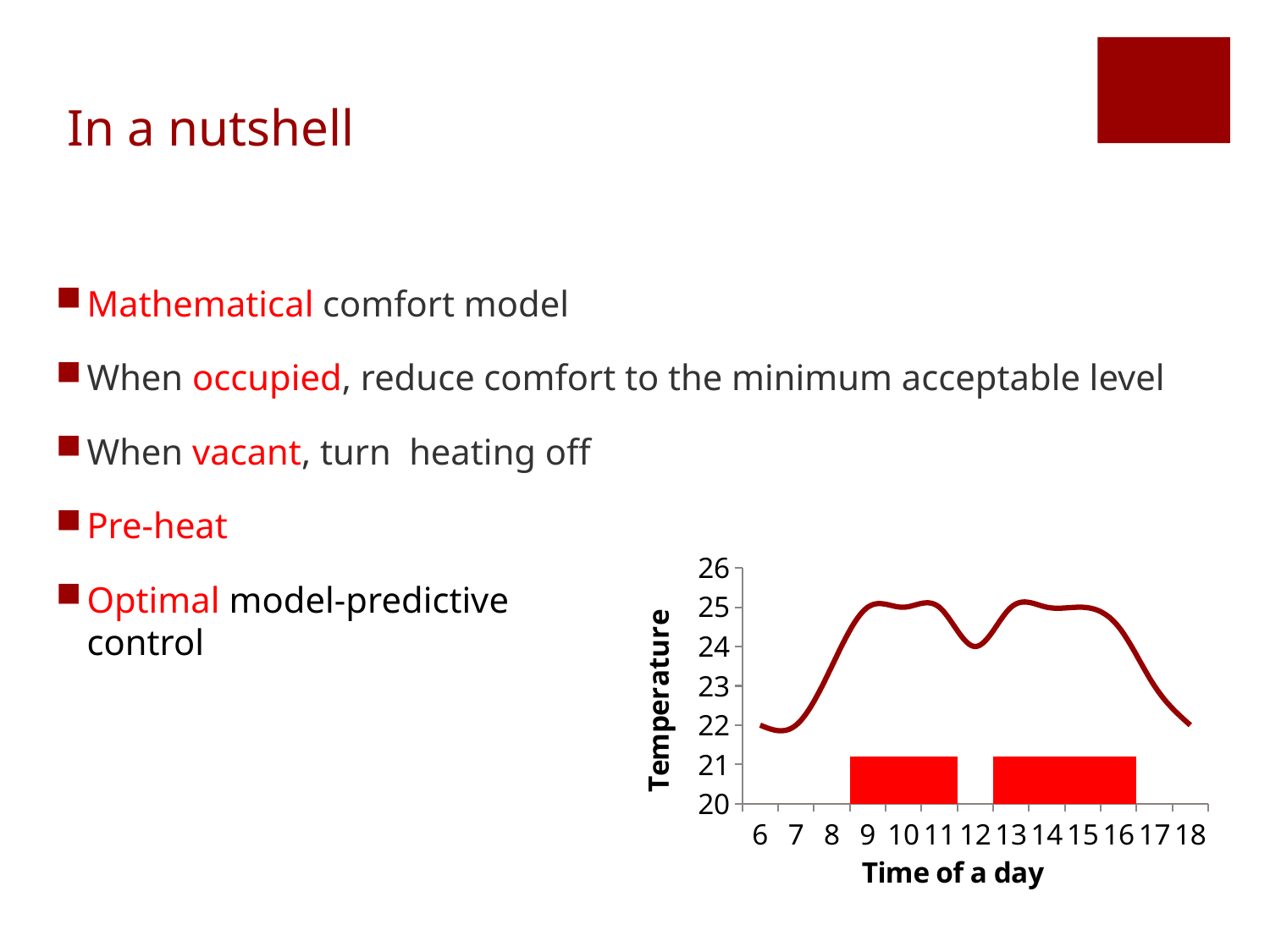
What kind of chart is used to show the temperature over the time of day? line chart Is the temperature at hour 10 greater or less than 24? greater Is the temperature at hour 12 greater or less than 25? less Is the temperature at hour 14 greater or less than 24? greater What is the label of the horizontal axis of the chart? Time of a day How many hour ticks are shown on the horizontal axis of the chart? 13 Does the temperature rise or fall between hour 16 and hour 18? fall What is the label of the vertical axis of the chart? Temperature Does the temperature rise or fall between hour 7 and hour 9? rise Which is higher, the temperature at hour 10 or at hour 6? hour 10